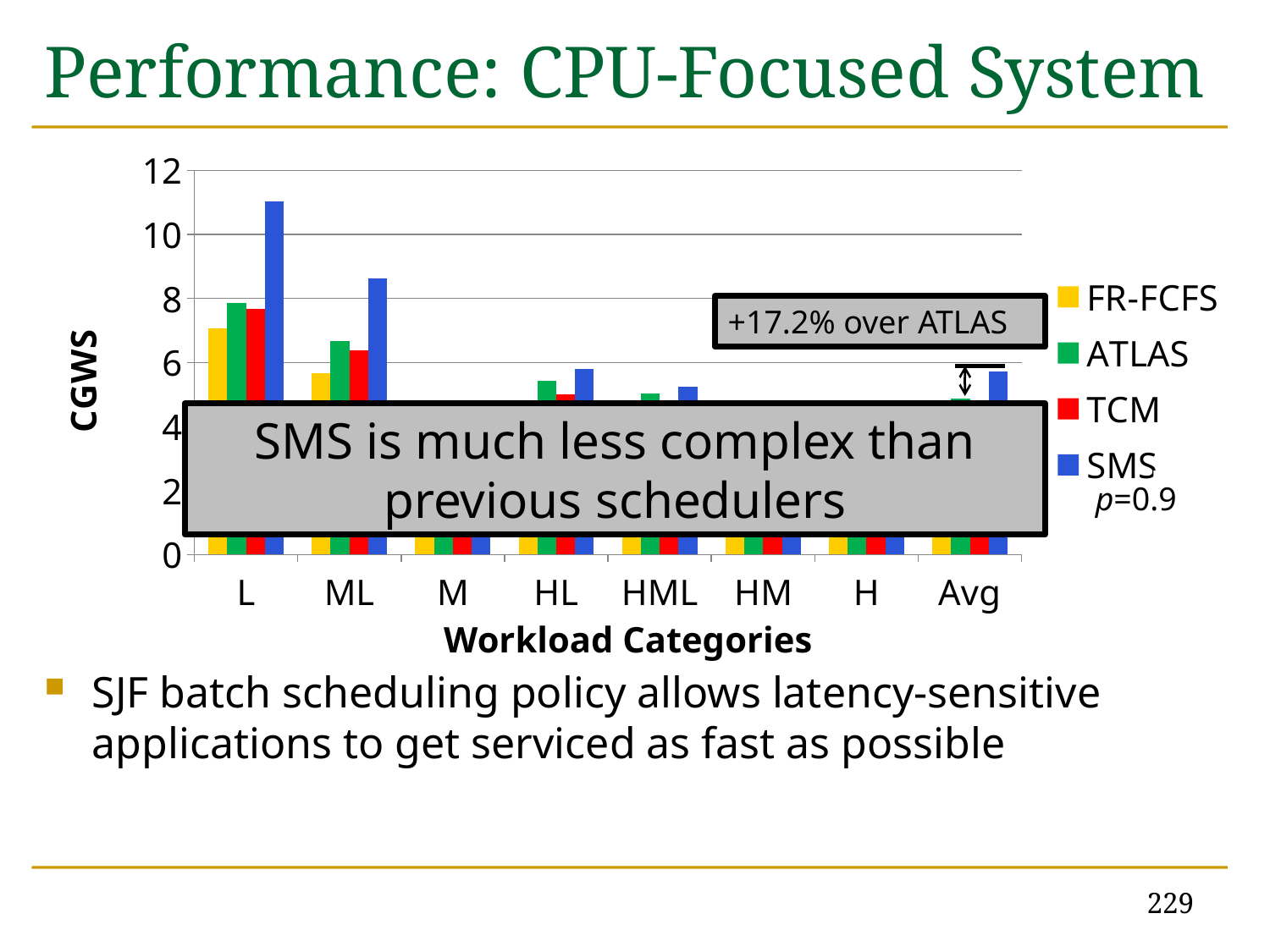
Which series has the highest value for workload category L? SMS What improvement over ATLAS does the annotation on the chart state? +17.2% over ATLAS Is the SMS value for workload category L greater or less than 10? greater How many series does the legend list? 4 How many workload categories are shown on the x axis? 8 Is the FR-FCFS value for workload category L greater or less than 6? greater For which workload category is the SMS value highest? L Is the SMS value for workload category ML greater or less than 8? greater For workload category L, which is larger: the SMS value or the TCM value? SMS What kind of chart is shown on the slide? bar chart What is the label of the y axis? CGWS